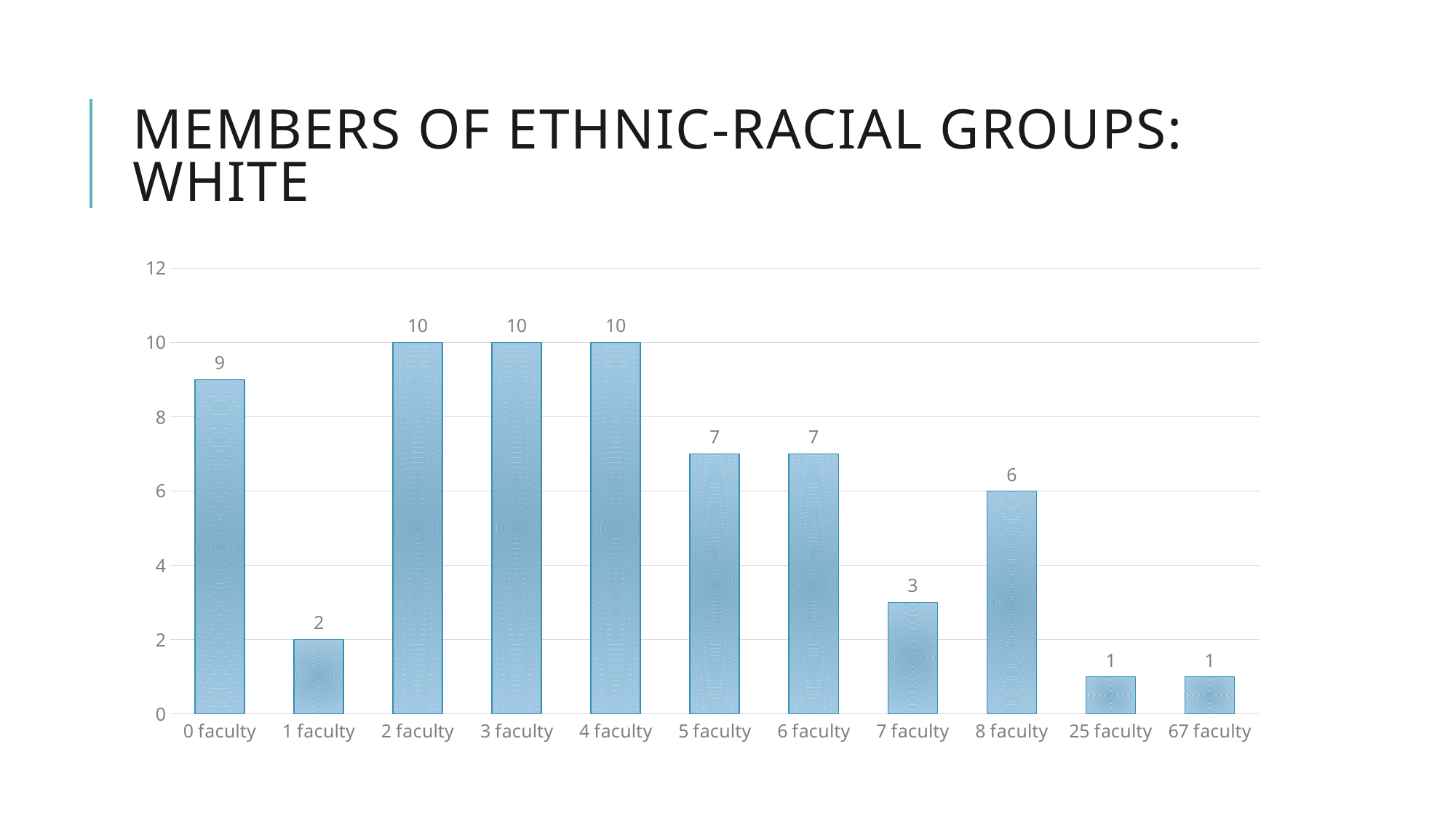
What is the value for the "7 faculty" category? 3 What is the difference between the values for "0 faculty" and "1 faculty"? 7 Which is larger, the value for "8 faculty" or the value for "5 faculty"? 5 faculty What is the highest value shown on the y axis? 12 What is the value for the "8 faculty" category? 6 Which category has the lowest value, "1 faculty" or "7 faculty"? 1 faculty What is the title of the slide? Members of Ethnic-Racial Groups: White What is the value for the "25 faculty" category? 1 How many categories are shown on the x axis? 11 What is the value for the "0 faculty" category? 9 What is the difference between the values for "5 faculty" and "7 faculty"? 4 What kind of chart is shown on the slide? Bar chart